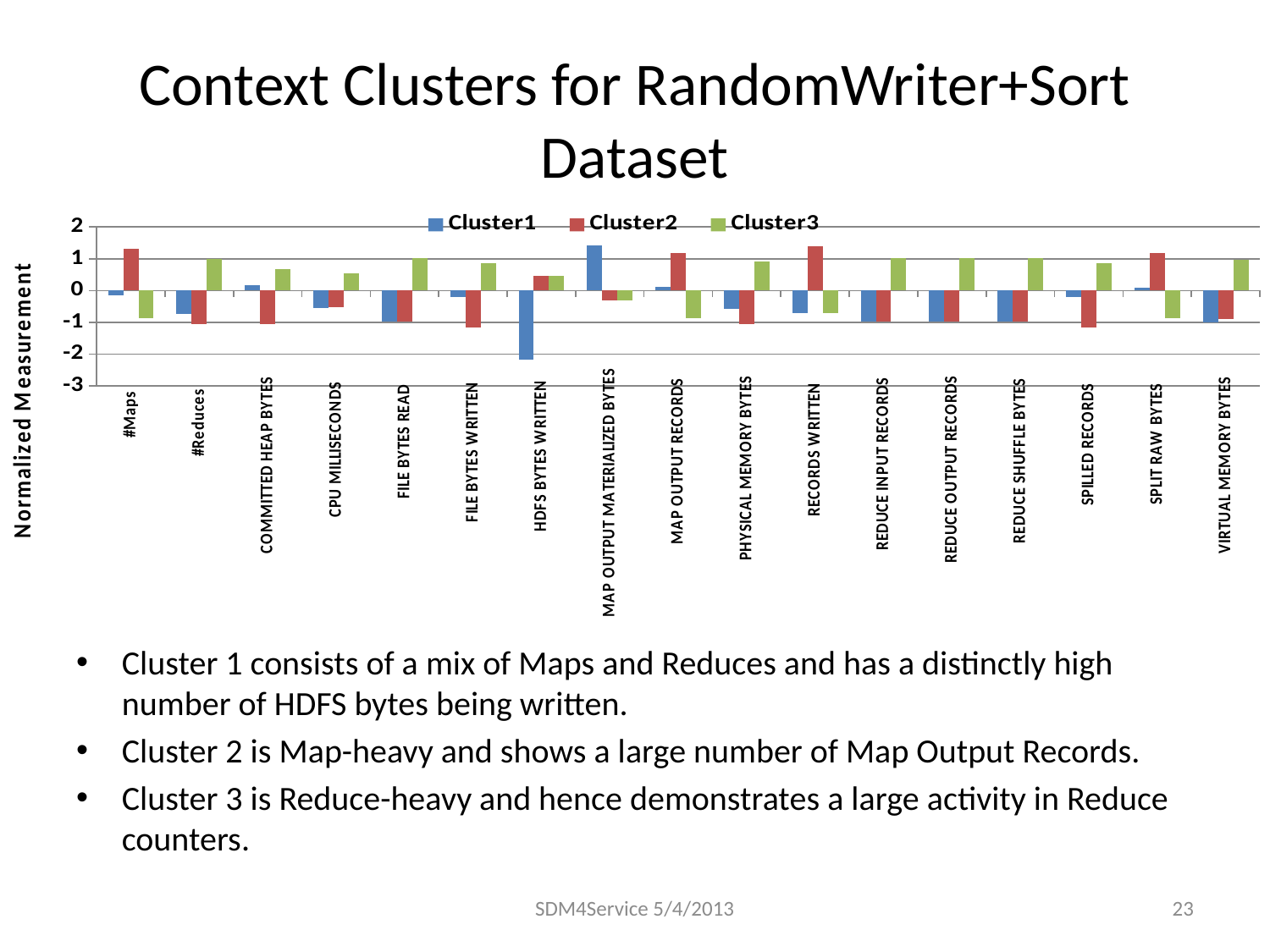
How many categories are shown along the x axis of the chart? 17 What is the title of the chart's vertical axis? Normalized Measurement For which category is the Cluster1 value highest? MAP OUTPUT MATERIALIZED BYTES How many series does the chart legend list? 3 What kind of chart is shown on the slide? bar chart For which category is the Cluster1 value lowest? HDFS BYTES WRITTEN Is the Cluster1 value for MAP OUTPUT MATERIALIZED BYTES greater or less than 1? greater For #Maps, which is larger: the Cluster2 value or the Cluster3 value? Cluster2 Is the Cluster2 value for RECORDS WRITTEN greater or less than 1? greater Is the Cluster2 value for SPILLED RECORDS greater or less than -1? less Which series is shown in green in the chart? Cluster3